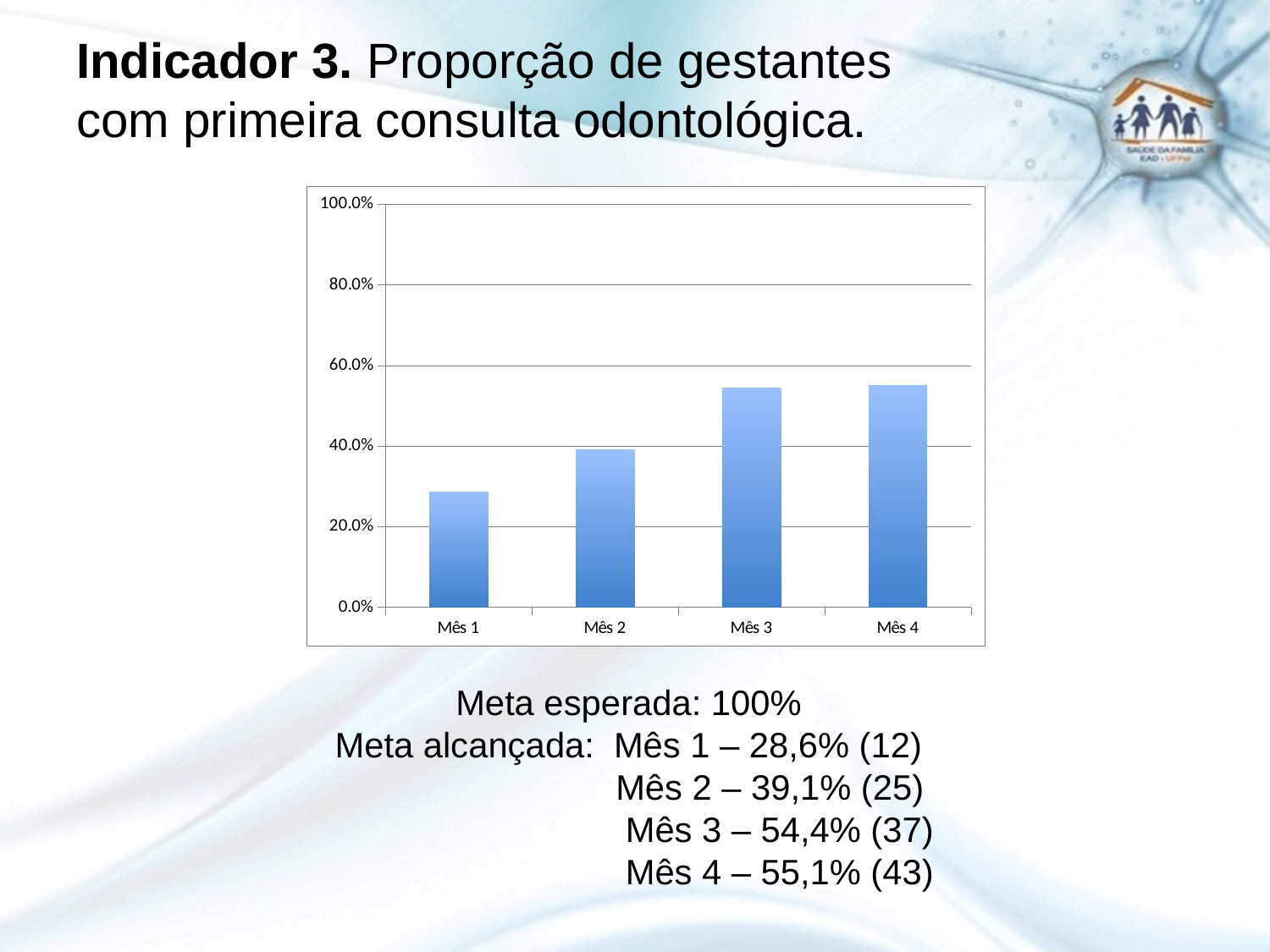
Is the value for Mês 3 greater or less than 60.0%? less Is the value for Mês 4 greater or less than 40.0%? greater Do the values rise or fall from Mês 1 to Mês 4? rise What kind of chart is shown on the slide? bar chart Which is larger, the value for Mês 1 or the value for Mês 2? Mês 2 Is the value for Mês 2 greater or less than 40.0%? less According to the text below the chart, what proportion was reached in Mês 3? 54,4% What is the expected target (meta esperada) stated on the slide? 100% Which month has the lowest bar in the chart? Mês 1 According to the text below the chart, what proportion was reached in Mês 1? 28,6% How many bars (months) are plotted in the chart? 4